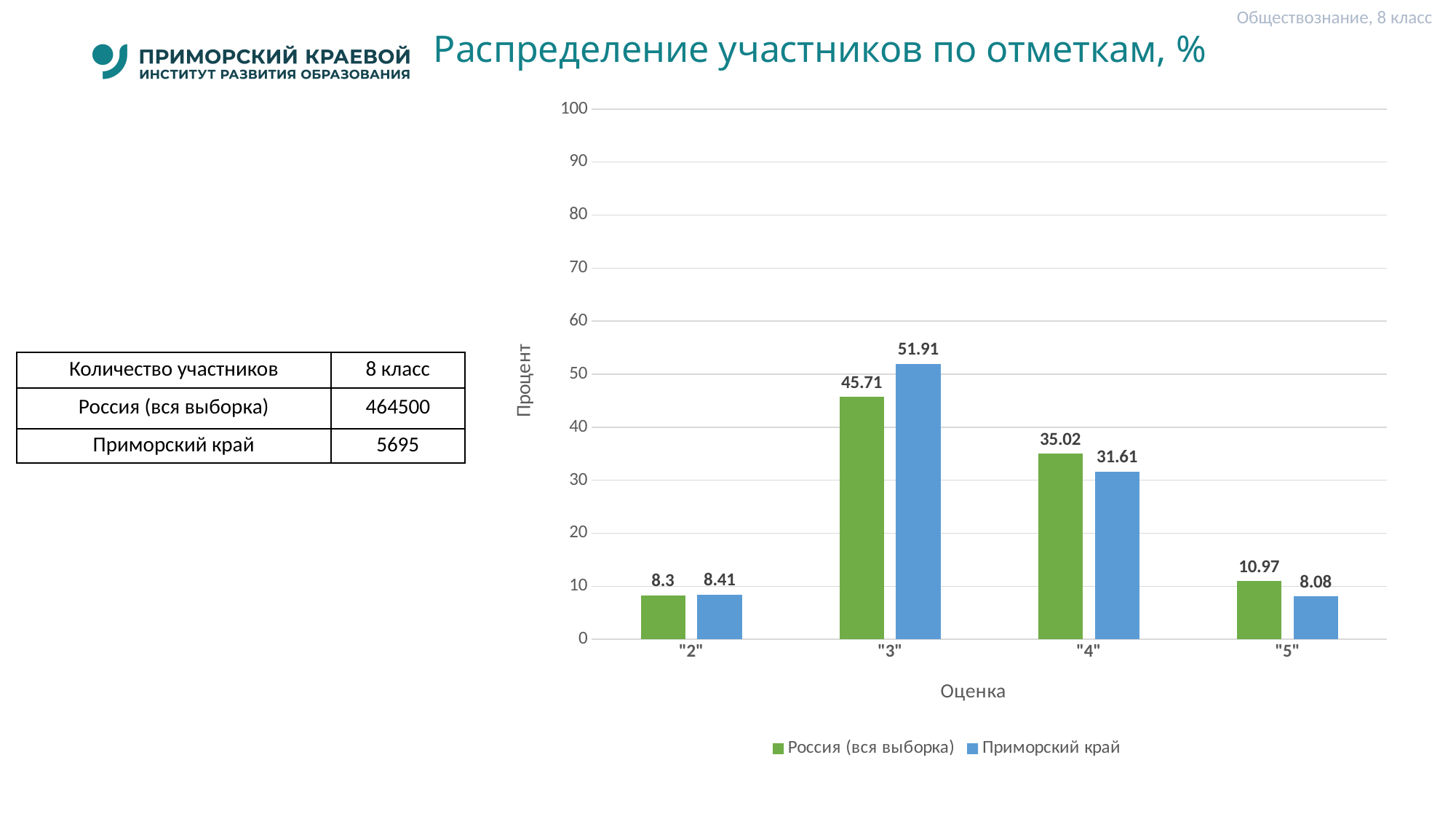
What is the value for Россия (вся выборка) at grade "4"? 35.02 Is the value for Приморский край at grade "3" greater or less than 50? greater At grade "3", which series has the larger value, Россия (вся выборка) or Приморский край? Приморский край Which grade has the highest value for Россия (вся выборка)? "3" What kind of chart is shown on the slide? bar chart What is the difference between Россия (вся выборка) and Приморский край at grade "4"? 3.41 What is the value for Приморский край at grade "3"? 51.91 Which grade has the lowest value for Приморский край? "5" What is the title of the chart? Распределение участников по отметкам, % How many series does the legend list? 2 What is the value for Приморский край at grade "5"? 8.08 How many grade categories are shown on the x axis? 4